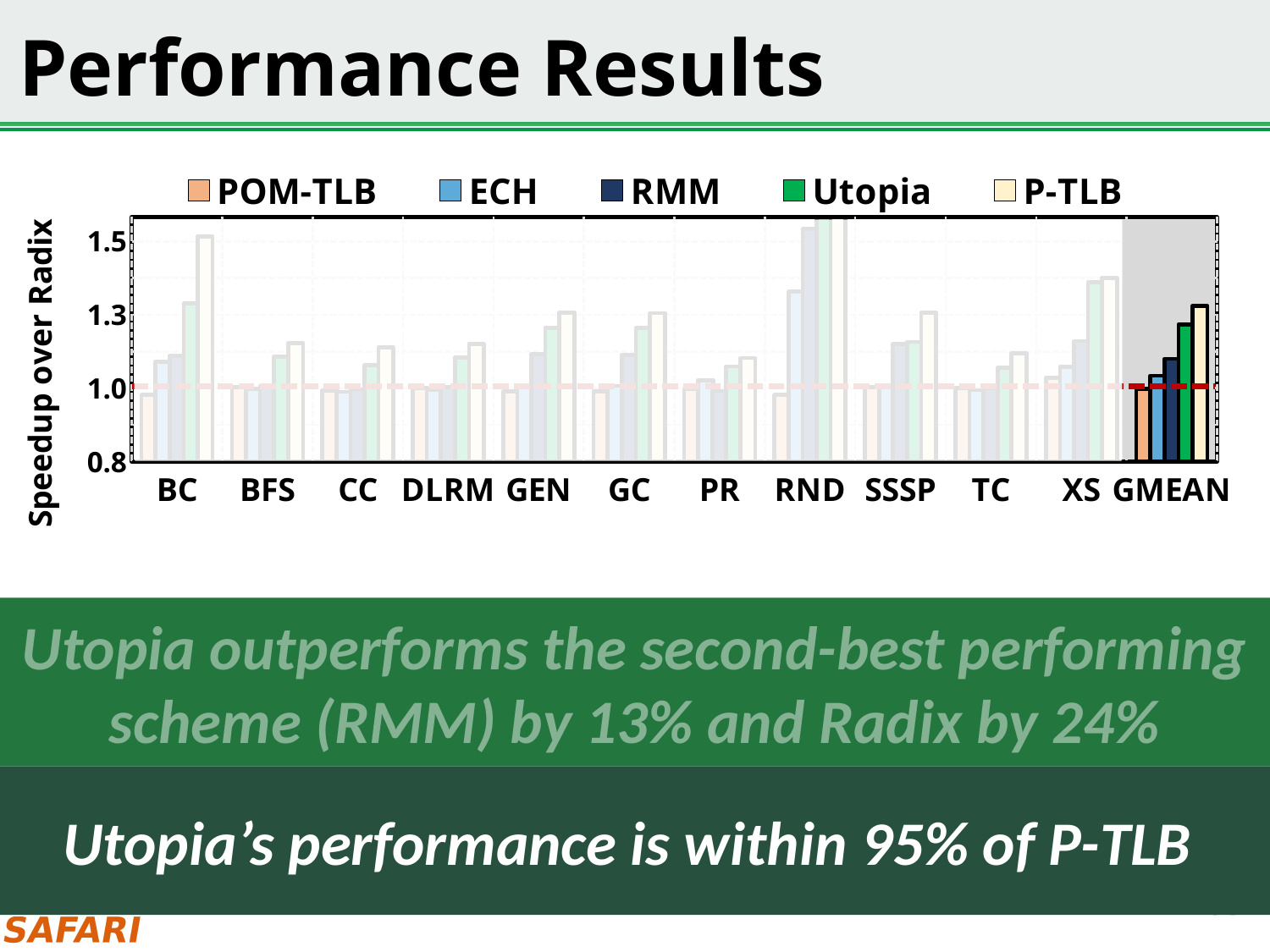
How many categories are shown along the x axis? 12 Which series is drawn in green? Utopia For GMEAN, which series has the lowest bar? POM-TLB What is the label of the y axis? Speedup over Radix What kind of chart is shown on the slide? bar chart Is the Utopia value for GMEAN greater or less than 1.0? greater How many series does the legend list? 5 Is the P-TLB value for RND greater or less than 1.5? greater Which category has the highest P-TLB bar? RND Is the P-TLB value for BC greater or less than 1.3? greater For GMEAN, which is larger: the Utopia value or the RMM value? Utopia